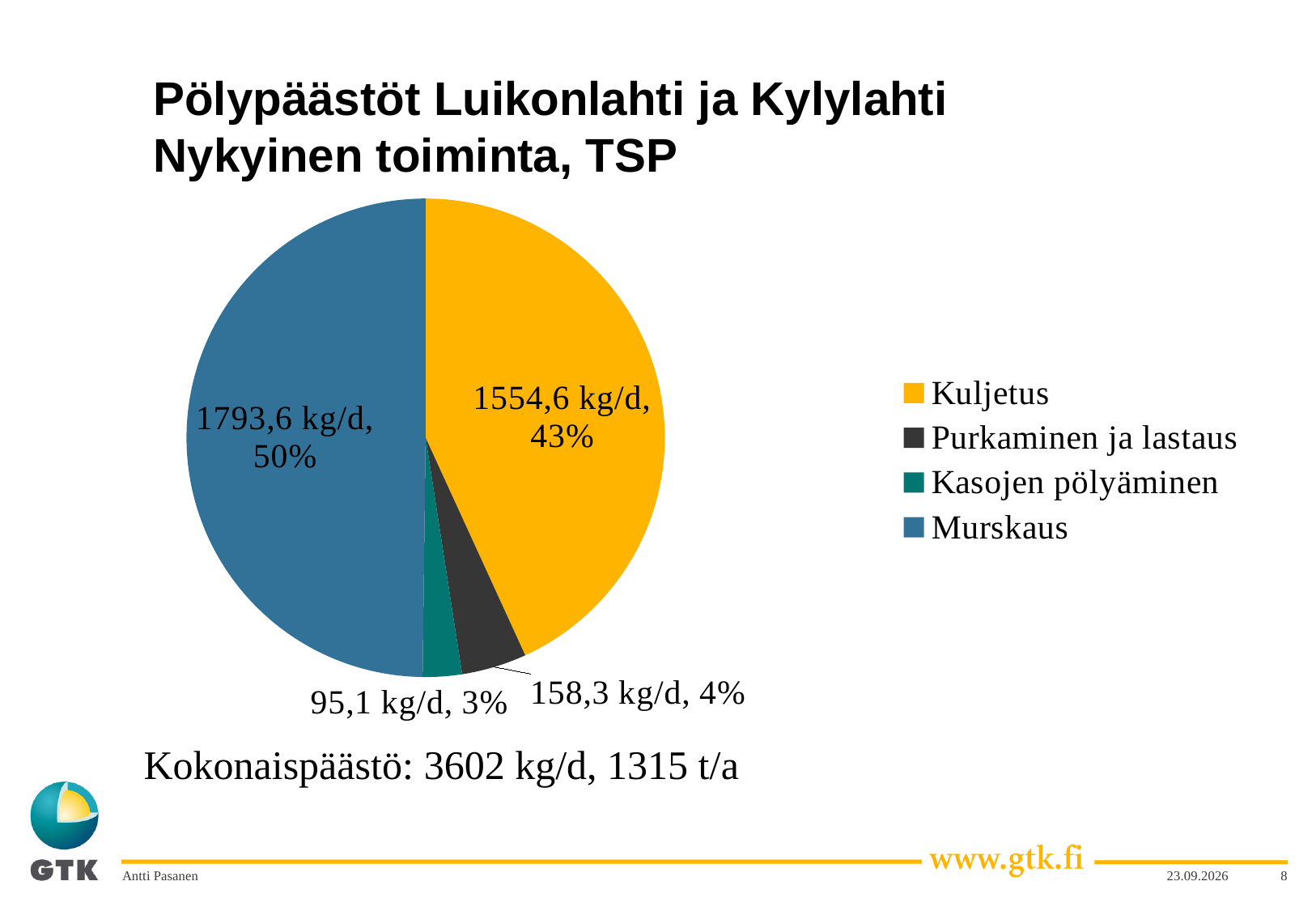
What colour is the Murskaus slice in the pie chart? blue Which is larger, the value for Purkaminen ja lastaus or the value for Kasojen pölyäminen? Purkaminen ja lastaus What is the value for Kasojen pölyäminen? 95,1 kg/d What is the value for Kuljetus? 1554,6 kg/d Which category has the largest share of the pie? Murskaus Which category has the smallest share of the pie? Kasojen pölyäminen What is the value for Purkaminen ja lastaus? 158,3 kg/d How many entries does the legend list? 4 How many slices does the pie chart have? 4 What kind of chart is shown on the slide? pie chart What share of the pie does Kuljetus represent? 43% What is the value for Murskaus? 1793,6 kg/d